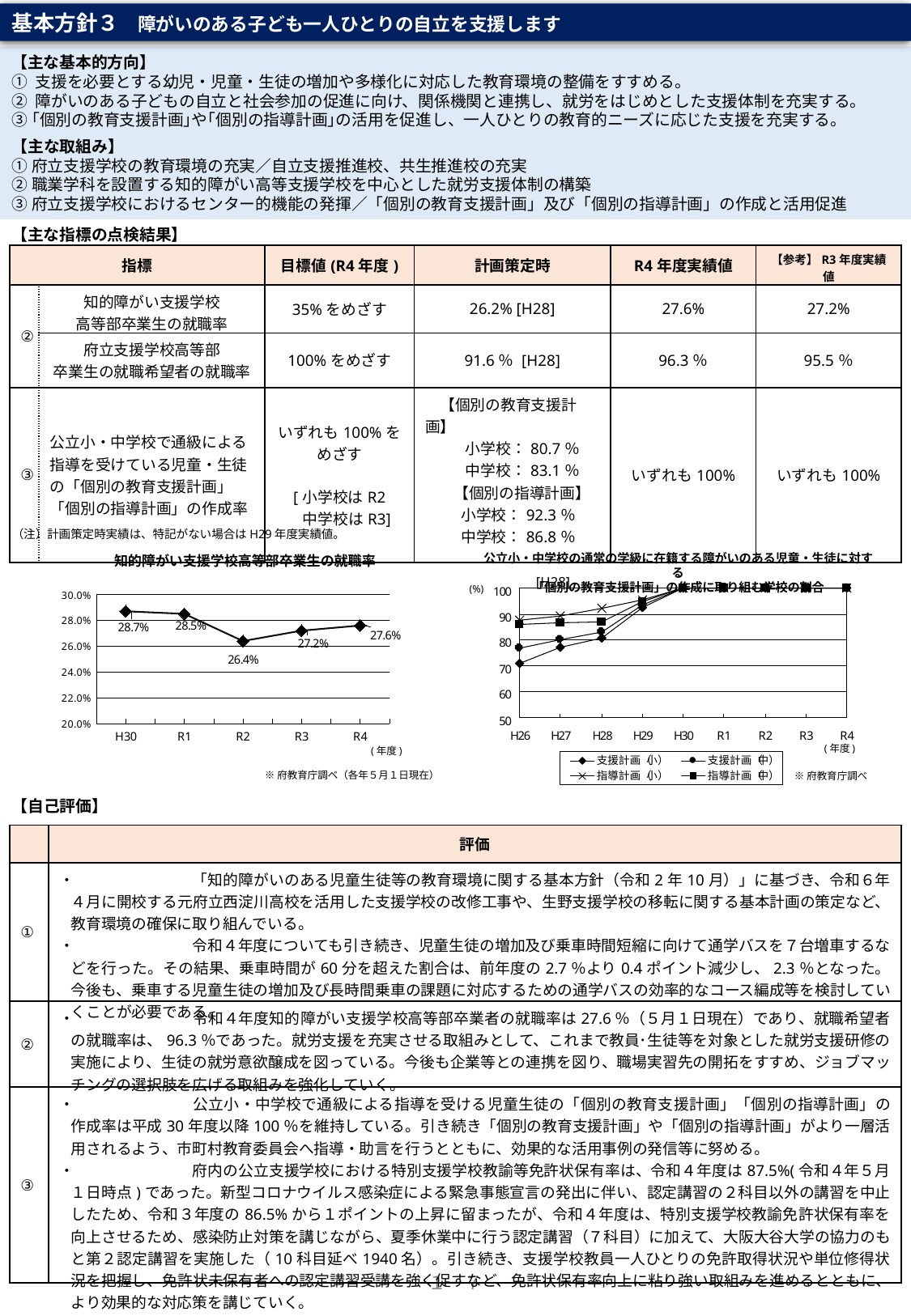
In the right chart, how many series does the legend list? 4 In the left chart (知的障がい支援学校高等部卒業生の就職率), how many years are plotted on the x axis? 5 In the left chart (知的障がい支援学校高等部卒業生の就職率), which year has the highest value? H30 In the right chart, do the values for 支援計画（小） rise or fall from H26 to R4? rise In the left chart (知的障がい支援学校高等部卒業生の就職率), what is the difference between the H30 value and the R2 value? 2.3 percentage points What kind of chart is the left chart (知的障がい支援学校高等部卒業生の就職率)? Line chart In the left chart (知的障がい支援学校高等部卒業生の就職率), which year has the lowest value? R2 In the left chart (知的障がい支援学校高等部卒業生の就職率), what is the value for H30? 28.7% In the left chart (知的障がい支援学校高等部卒業生の就職率), what is the value for R4? 27.6% In the left chart (知的障がい支援学校高等部卒業生の就職率), which is larger, the value for R3 or the value for R4? R4 In the right chart, is the value for 支援計画（中） at H26 greater or less than 80? less In the left chart (知的障がい支援学校高等部卒業生の就職率), what is the value for R2? 26.4%